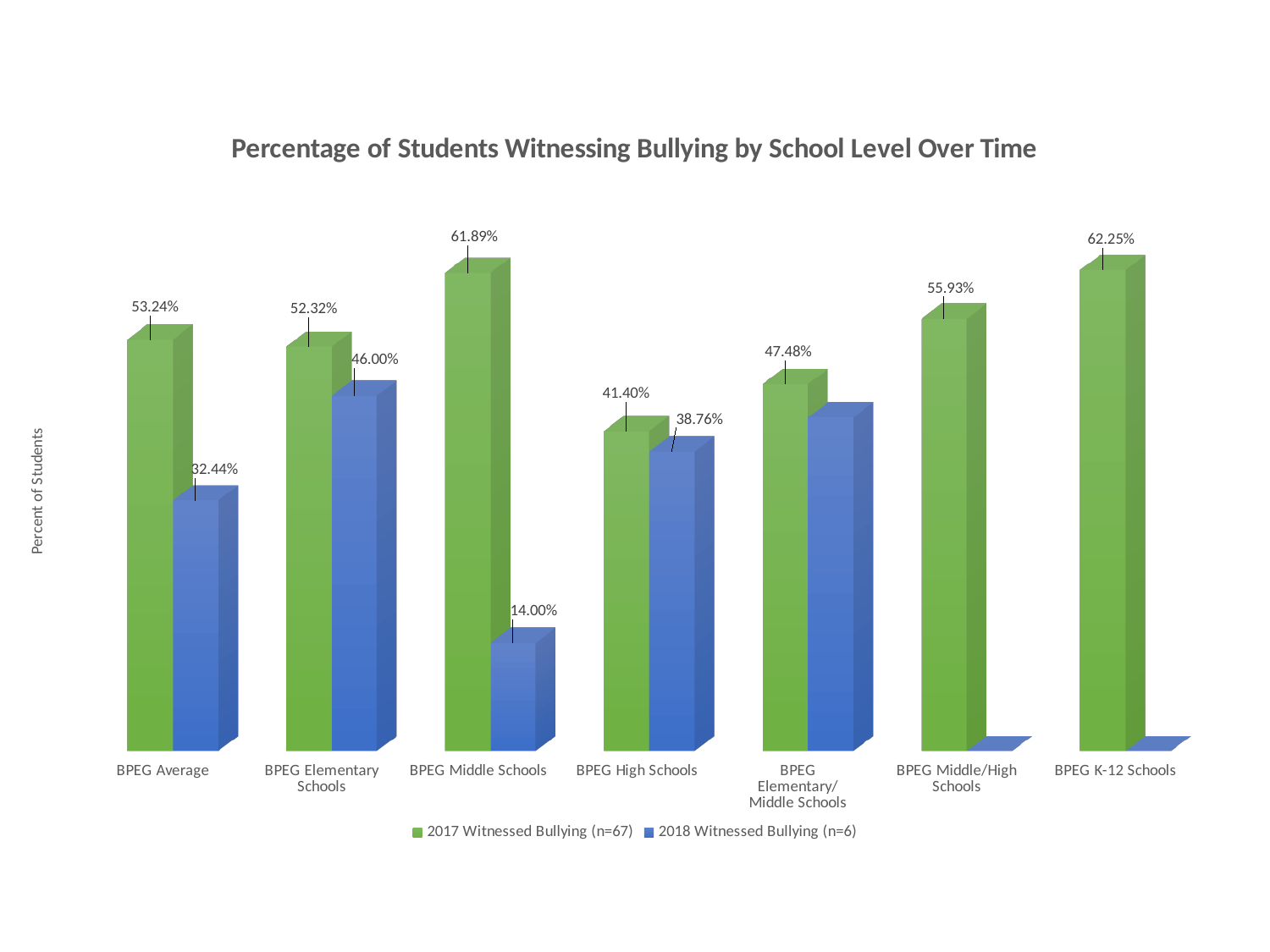
What is the 2018 Witnessed Bullying value for BPEG Average? 32.44% How many series does the legend list? 2 What is the difference between the 2017 and 2018 Witnessed Bullying values for BPEG Middle Schools? 47.89% Among the labelled 2018 Witnessed Bullying values, which school level has the lowest? BPEG Middle Schools Which school level has the highest 2017 Witnessed Bullying value? BPEG K-12 Schools Which school level has the lowest 2017 Witnessed Bullying value? BPEG High Schools How many school-level categories are shown on the x axis? 7 Which is larger for BPEG High Schools: the 2017 or the 2018 Witnessed Bullying value? 2017 What is the 2018 Witnessed Bullying value for BPEG Elementary Schools? 46.00% What type of chart is shown on the slide? Bar chart What is the 2017 Witnessed Bullying value for BPEG High Schools? 41.40% What is the 2017 Witnessed Bullying value for BPEG Middle Schools? 61.89%